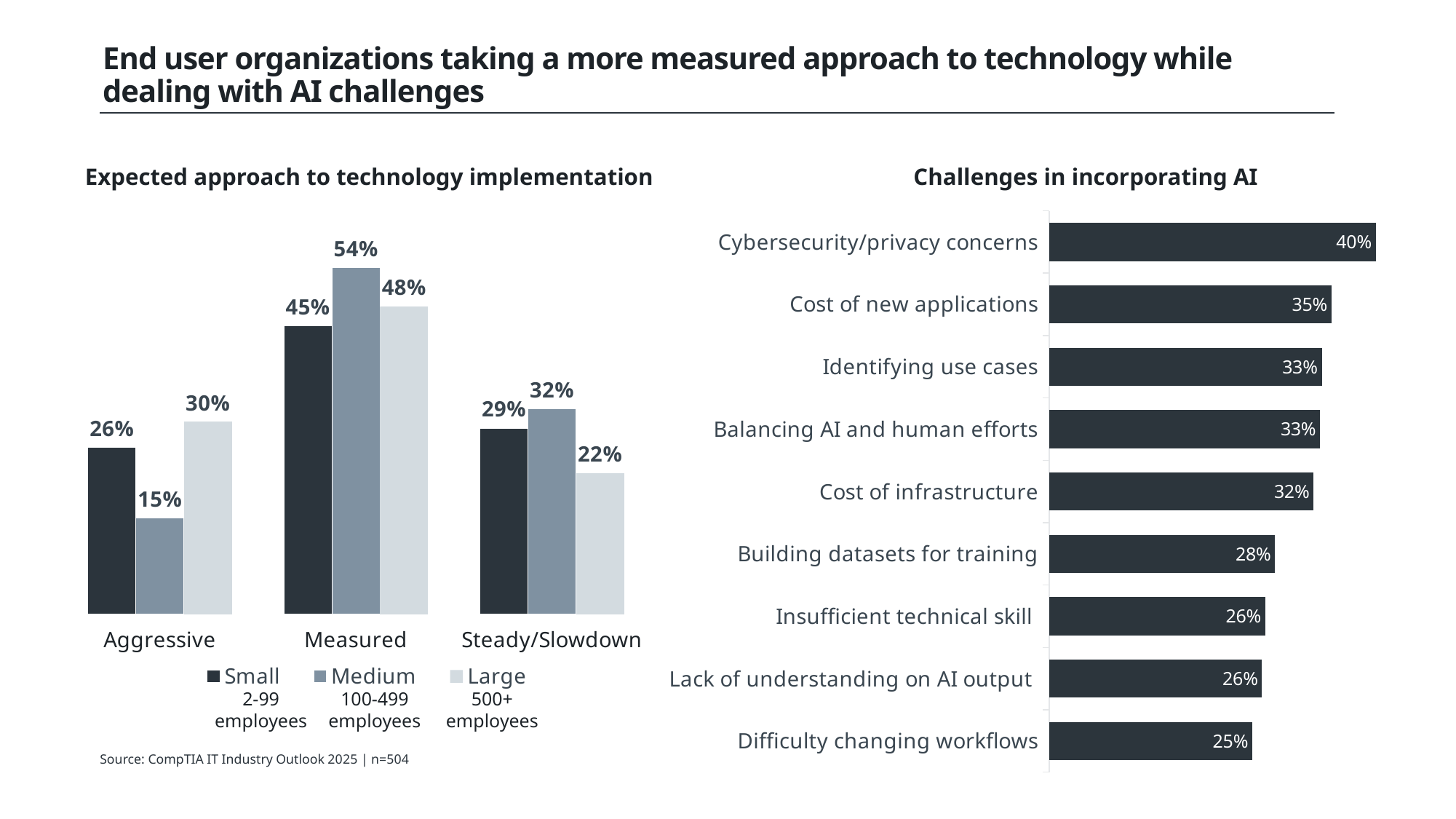
In the 'Expected approach to technology implementation' chart, what is the value for Large organizations under Steady/Slowdown? 22% In the 'Challenges in incorporating AI' chart, what is the value for Cost of new applications? 35% In the 'Expected approach to technology implementation' chart, how many series does the legend list? 3 In the 'Expected approach to technology implementation' chart, what is the value for Medium organizations under Measured? 54% What kind of chart is the 'Challenges in incorporating AI' chart? Bar chart In the 'Expected approach to technology implementation' chart, what is the difference between the Medium and Small values under Measured? 9% In the 'Challenges in incorporating AI' chart, which challenge has the highest value? Cybersecurity/privacy concerns In the 'Expected approach to technology implementation' chart, what is the value for Small organizations under Aggressive? 26% In the 'Challenges in incorporating AI' chart, how many challenges are listed? 9 In the 'Expected approach to technology implementation' chart, which is larger under Steady/Slowdown: Small or Medium? Medium In the 'Challenges in incorporating AI' chart, which challenge has the lowest value? Difficulty changing workflows In the 'Expected approach to technology implementation' chart, which size category has the lowest value under Aggressive? Medium